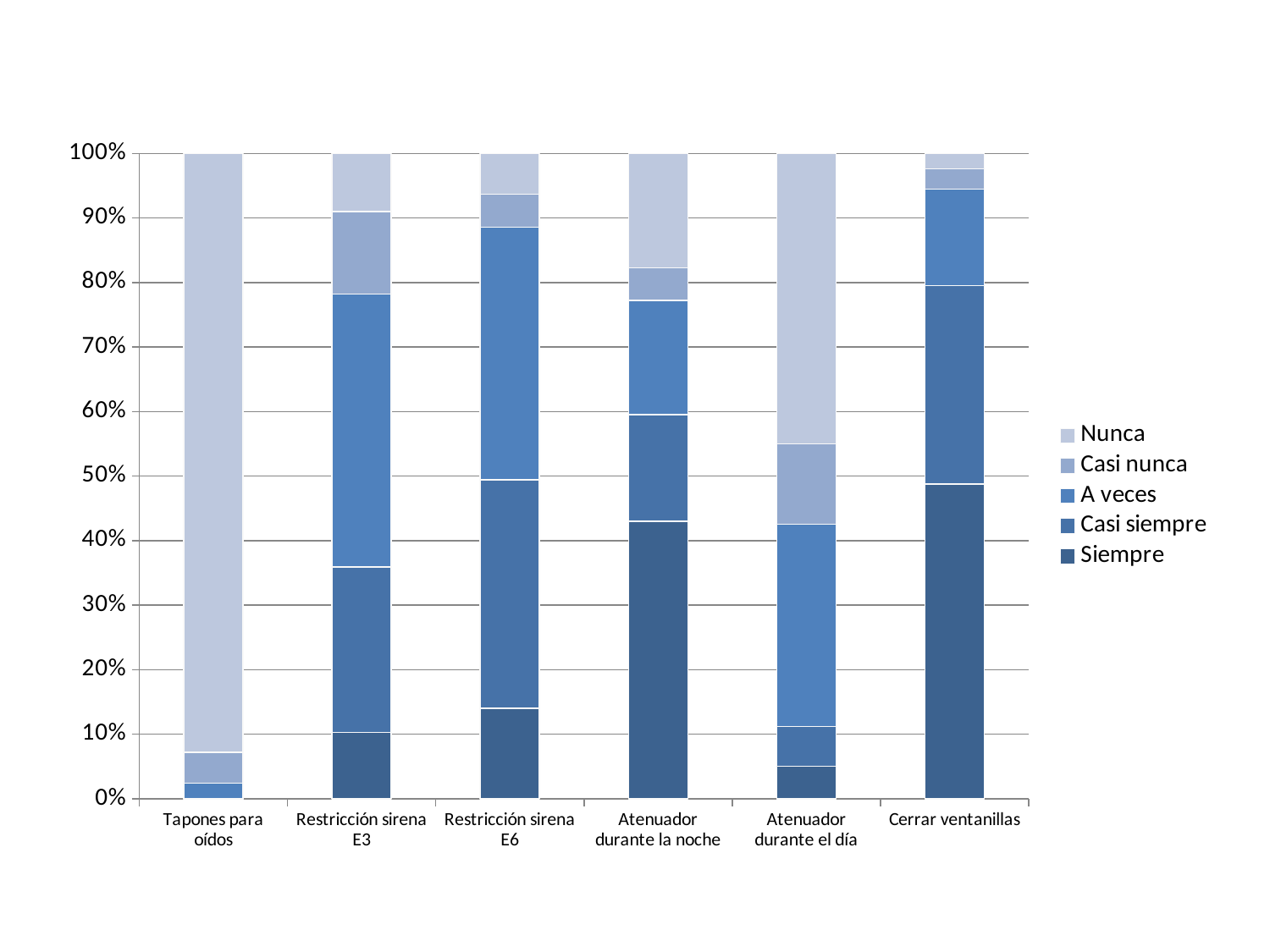
Is the 'Siempre' share for Atenuador durante el día greater or less than 10%? less Which has a larger 'Nunca' segment: Atenuador durante el día or Restricción sirena E3? Atenuador durante el día Which category has the smallest 'Nunca' segment? Cerrar ventanillas Which category has the largest 'Siempre' segment? Cerrar ventanillas How many series does the legend list? 5 How many categories are shown along the x axis? 6 Which category has the largest 'Nunca' segment? Tapones para oídos What kind of chart is shown on the slide? stacked bar chart Which has a larger 'Siempre' segment: Atenuador durante la noche or Atenuador durante el día? Atenuador durante la noche Is the 'Siempre' share for Atenuador durante la noche greater or less than 40%? greater Which series is listed first in the legend? Nunca Is the 'Nunca' share for Tapones para oídos greater or less than 80%? greater